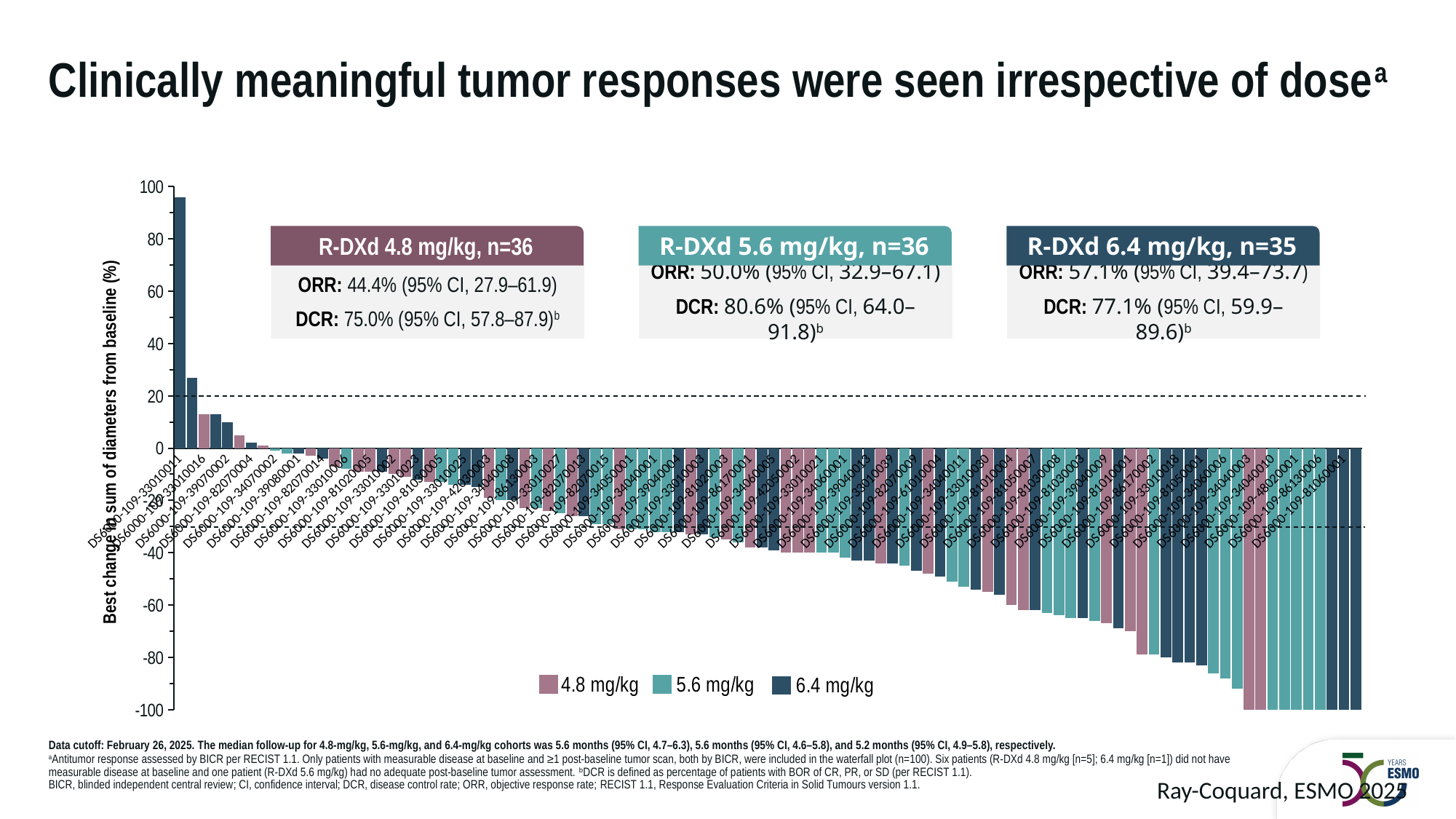
Is the value of the tallest (leftmost) bar greater or less than 80? greater Is the value of the third bar from the left greater or less than 20? less How many series does the legend list? 3 Do the bar values rise or fall moving from left to right along the x axis? fall What are the three entries in the chart legend? 4.8 mg/kg, 5.6 mg/kg, 6.4 mg/kg Is the value of the second bar from the left greater or less than 20? greater What is the label of the vertical axis? Best change in sum of diameters from baseline (%) Which is larger, the leftmost bar or the second bar from the left? the leftmost bar Which dose series does the tallest bar belong to? 6.4 mg/kg What kind of chart is shown on the slide? bar chart According to the footnote, how many patients are included in the waterfall plot? 100 What is the lowest value reached by the bars at the right end of the chart? -100